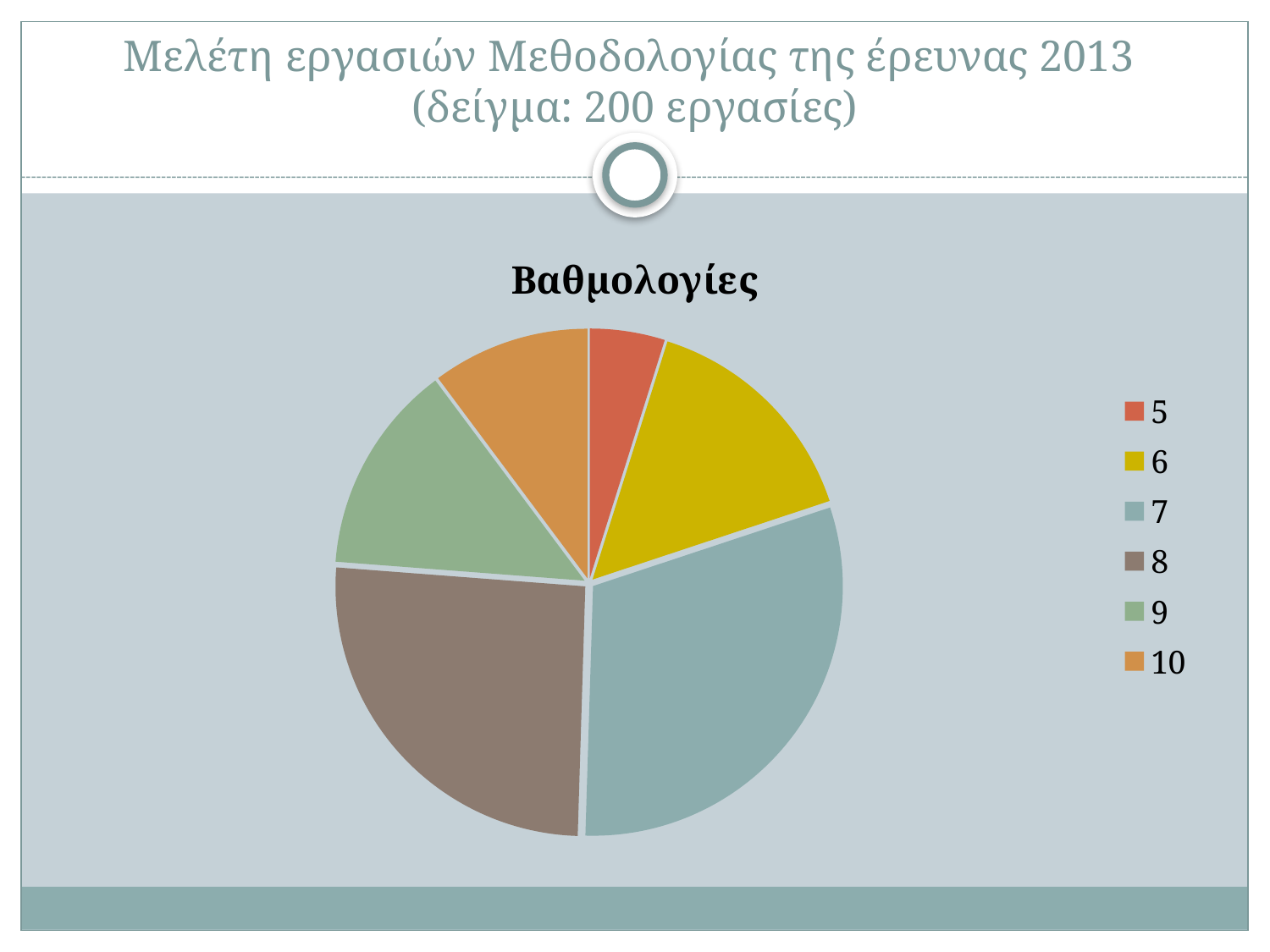
How many entries does the legend of the pie chart list? 6 Which slice is larger, the one for grade 7 or the one for grade 8? 7 What colour is the slice for grade 8 in the pie chart? brown Which grade has the smallest slice in the pie chart? 5 Which slice is larger, the one for grade 6 or the one for grade 5? 6 Which grade has the largest slice in the pie chart? 7 Which slice is larger, the one for grade 5 or the one for grade 10? 10 How many slices does the pie chart have? 6 What is the title of the pie chart? Βαθμολογίες What kind of chart is shown on the slide? pie chart